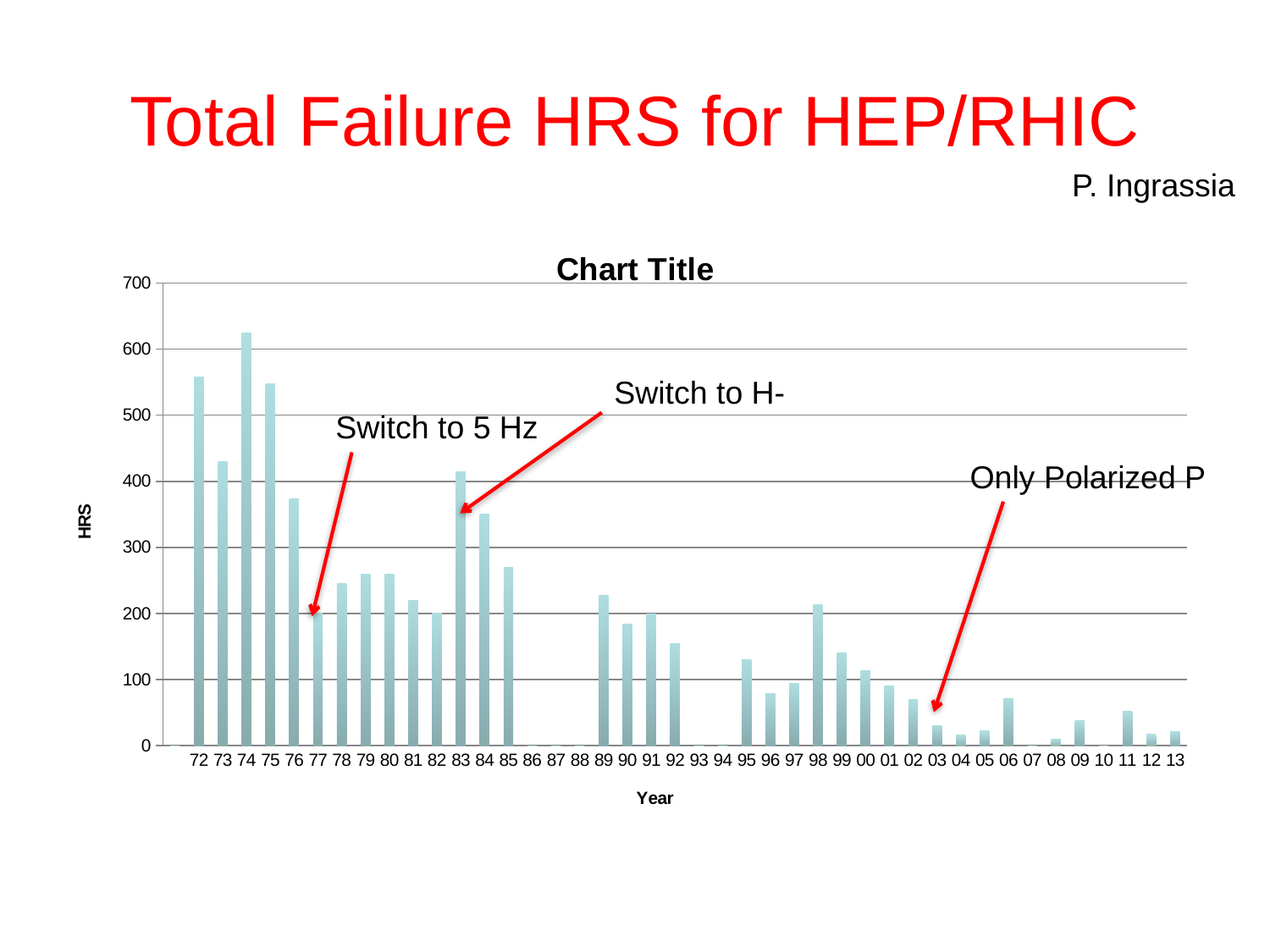
Is the value for year 72 greater or less than 500? greater Is the value for year 74 greater or less than 600? greater Is the value for year 83 greater or less than 400? greater Which year has the highest total failure HRS? 74 Overall, do the values rise or fall from year 72 to year 13? fall What is the label on the vertical axis? HRS Which is larger, the value for year 72 or year 73? 72 What is the label on the horizontal axis? Year Which is larger, the value for year 98 or year 99? 98 What kind of chart is shown on the slide? bar chart